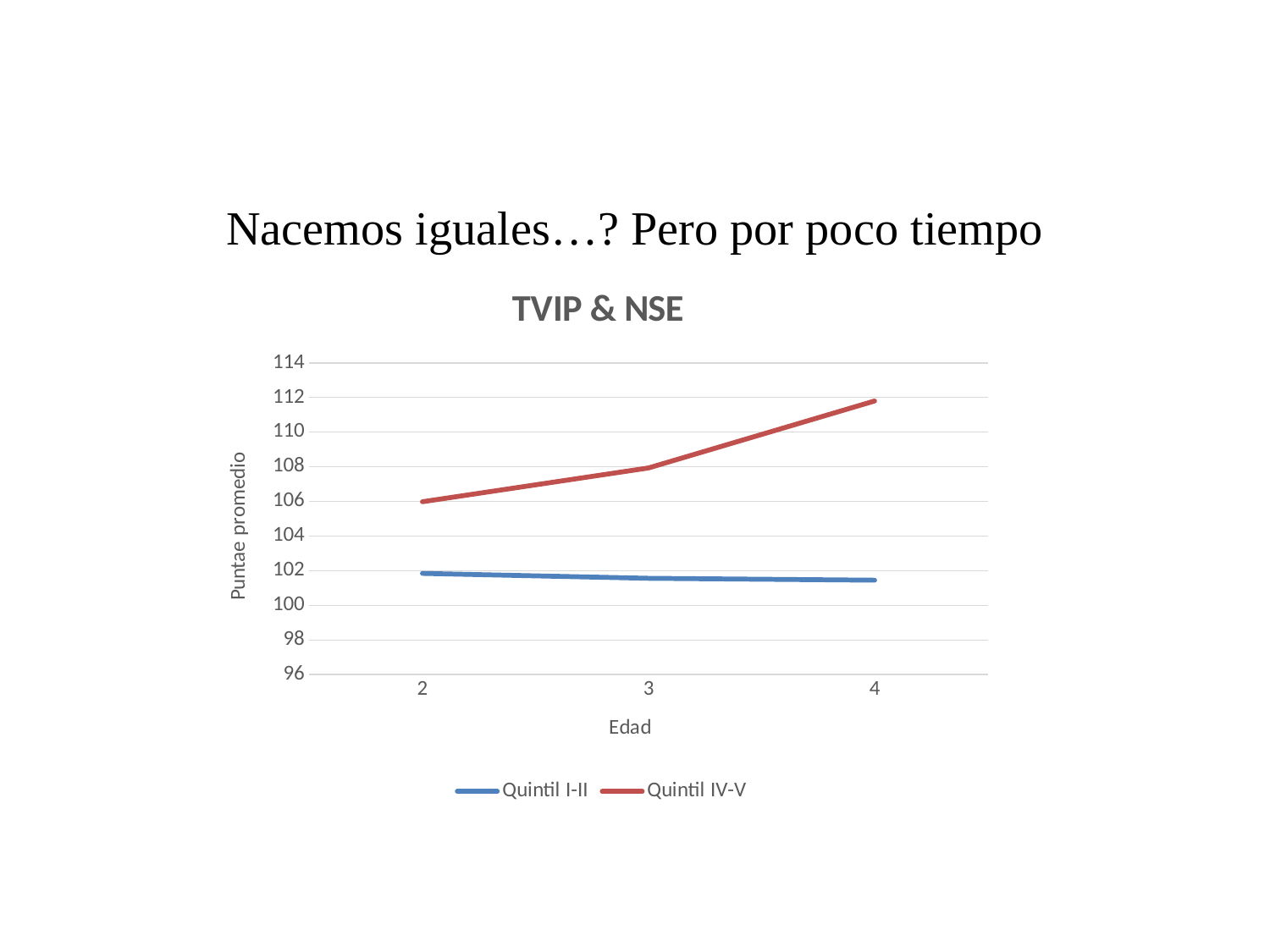
What kind of chart is shown on the slide? line chart At Edad 4, which series has the larger value, Quintil I-II or Quintil IV-V? Quintil IV-V At which Edad does the Quintil IV-V series reach its highest value? 4 How many age points are plotted along the x axis? 3 Does the Quintil IV-V line rise or fall as Edad increases from 2 to 4? rise Is the value for Quintil I-II at Edad 2 greater or less than 104? less Does the Quintil I-II line rise or fall as Edad increases from 2 to 4? fall How many series does the legend list? 2 What is the title of the chart? TVIP & NSE What is the label of the x axis? Edad Is the value for Quintil IV-V at Edad 4 greater or less than 110? greater Is the value for Quintil IV-V at Edad 3 greater or less than 104? greater